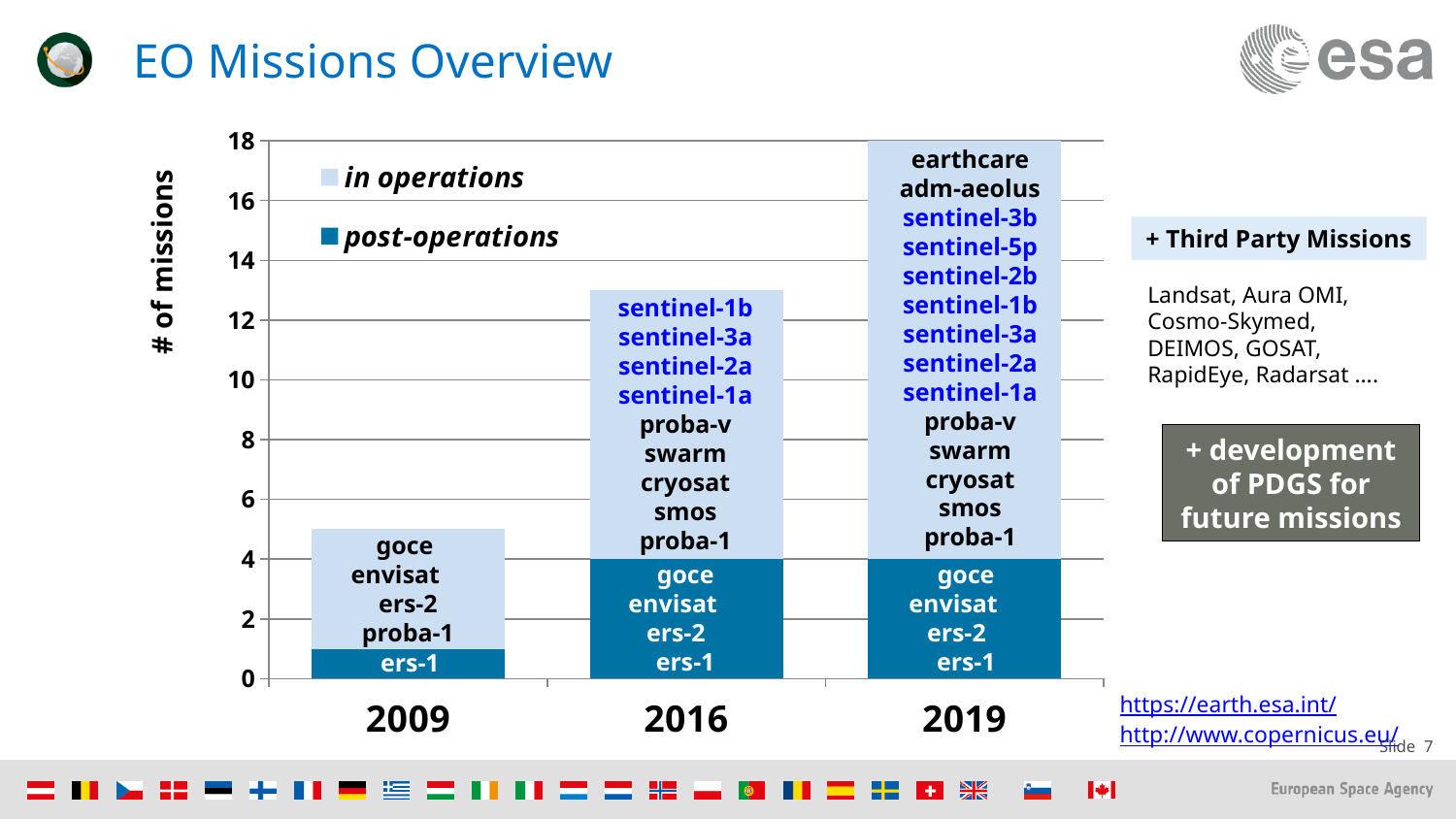
What is the value of the post-operations segment for 2016? 4 What is the total number of missions shown for 2019? 18 Which year has the lowest total number of missions? 2009 Which year has the highest total number of missions? 2019 What kind of chart is shown on the slide? bar chart How many series does the chart legend list? 2 What is the value of the post-operations segment for 2019? 4 Does the total number of missions rise or fall from 2009 to 2019? rise What is the label of the y axis of the chart? # of missions Is the total number of missions for 2016 greater or less than 12? greater Is the total number of missions for 2009 greater or less than 6? less How many years are shown along the x axis of the chart? 3